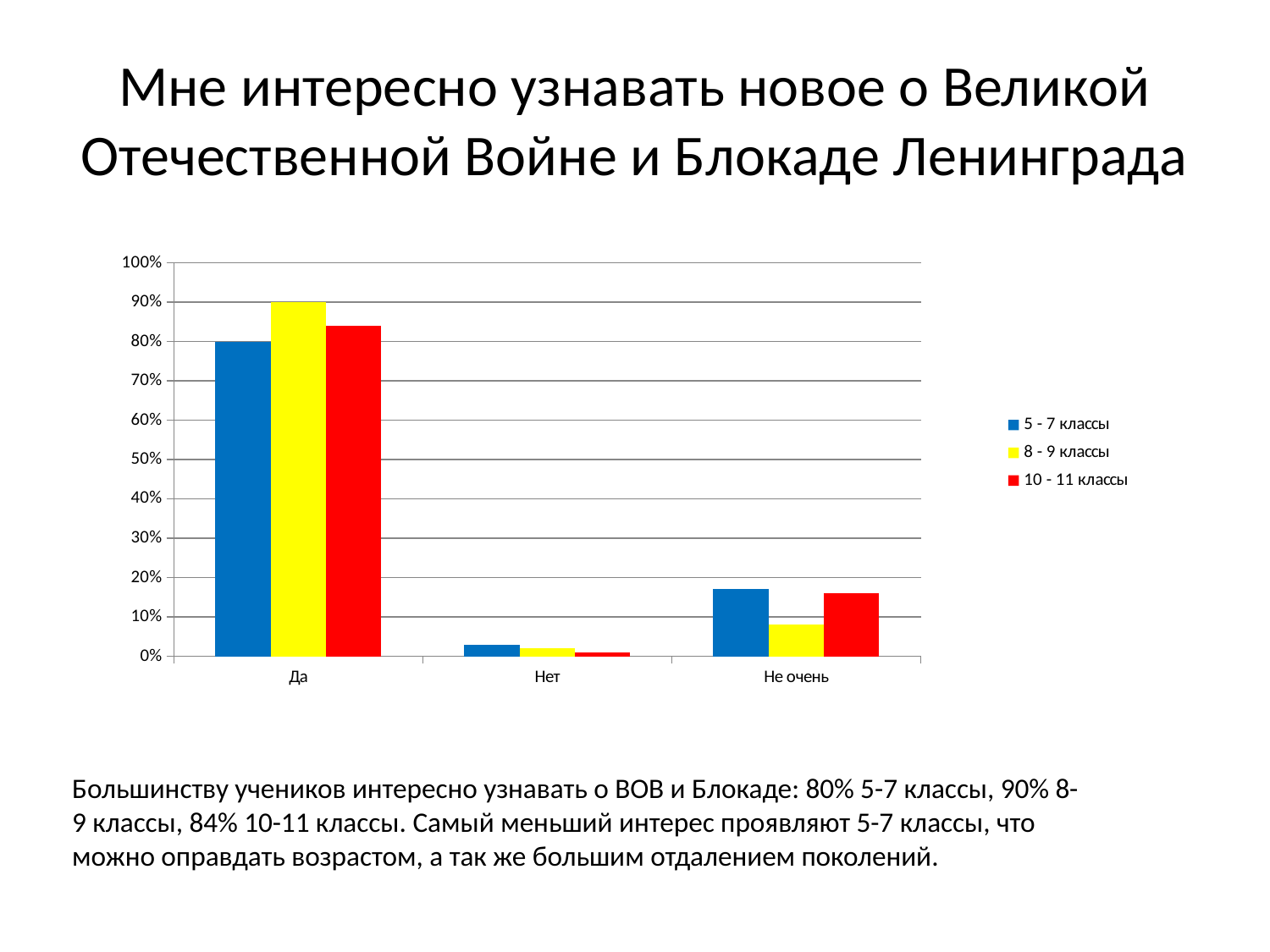
What is the value for 8 - 9 классы in the Да category? 90% What is the value for 5 - 7 классы in the Да category? 80% How many categories are shown on the x axis? 3 Is the value for 10 - 11 классы in the Нет category greater or less than 10%? less How many series does the legend list? 3 What is the value for 10 - 11 классы in the Да category? 84% What is the difference between the 8 - 9 классы and 5 - 7 классы values in the Да category? 10% Is the value for 5 - 7 классы in the Не очень category greater or less than 10%? greater What type of chart is shown on the slide? bar chart Which series has the lowest value in the Да category? 5 - 7 классы Which series has the highest value in the Да category? 8 - 9 классы Which colour represents 10 - 11 классы in the legend? red